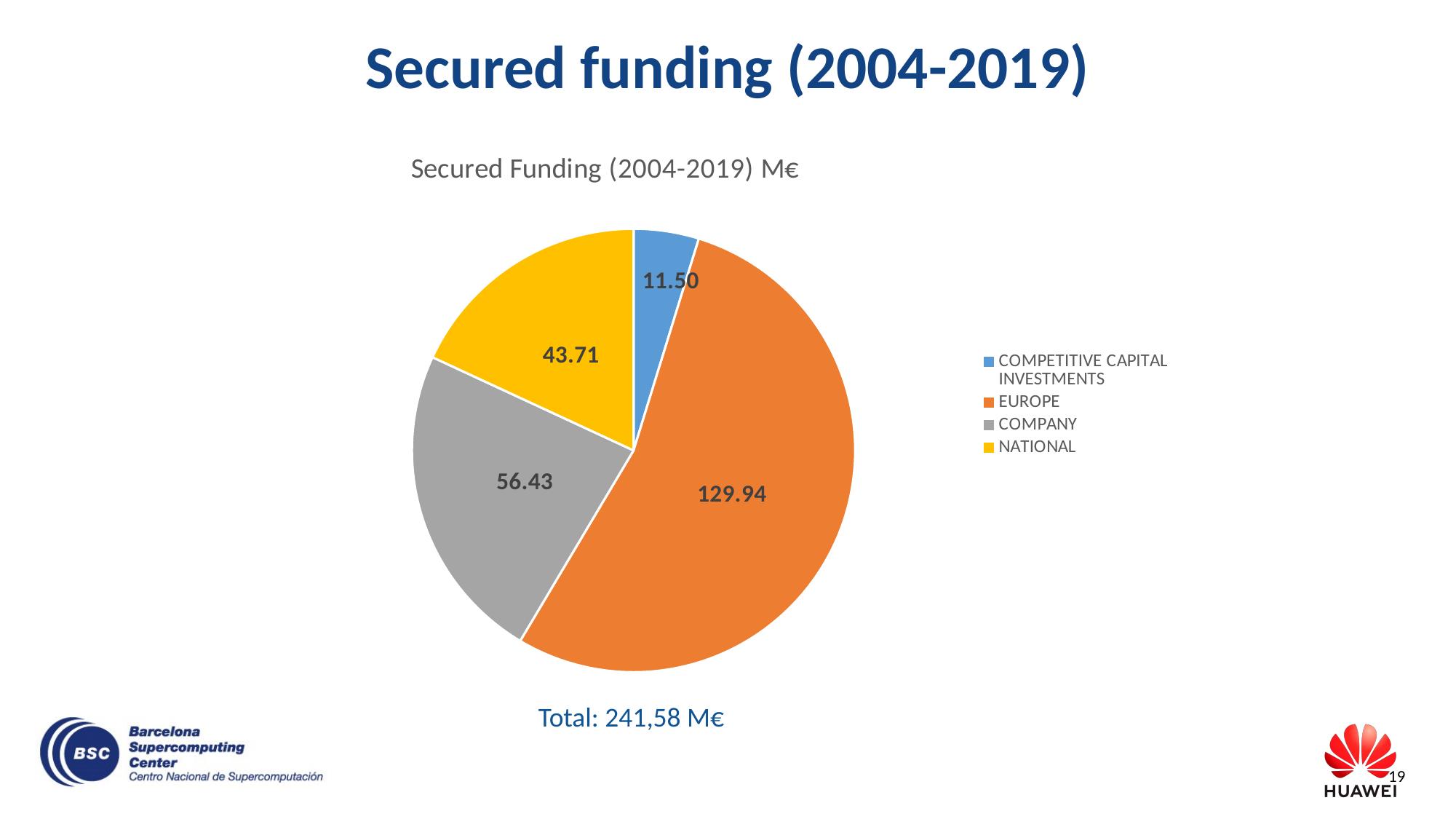
What is the value for NATIONAL in the pie chart? 43.71 What is the value for EUROPE in the pie chart? 129.94 What is the value for COMPETITIVE CAPITAL INVESTMENTS in the pie chart? 11.50 Which is larger, the value for COMPANY or the value for NATIONAL? COMPANY What is the value for COMPANY in the pie chart? 56.43 What type of chart is shown on the slide? Pie chart Which category has the smallest slice of the pie chart? COMPETITIVE CAPITAL INVESTMENTS What total is stated below the pie chart? 241,58 M€ What is the difference between the EUROPE value and the COMPANY value? 73.51 How many categories does the pie chart have? 4 Which category has the largest slice of the pie chart? EUROPE What is the difference between the COMPANY value and the NATIONAL value? 12.72